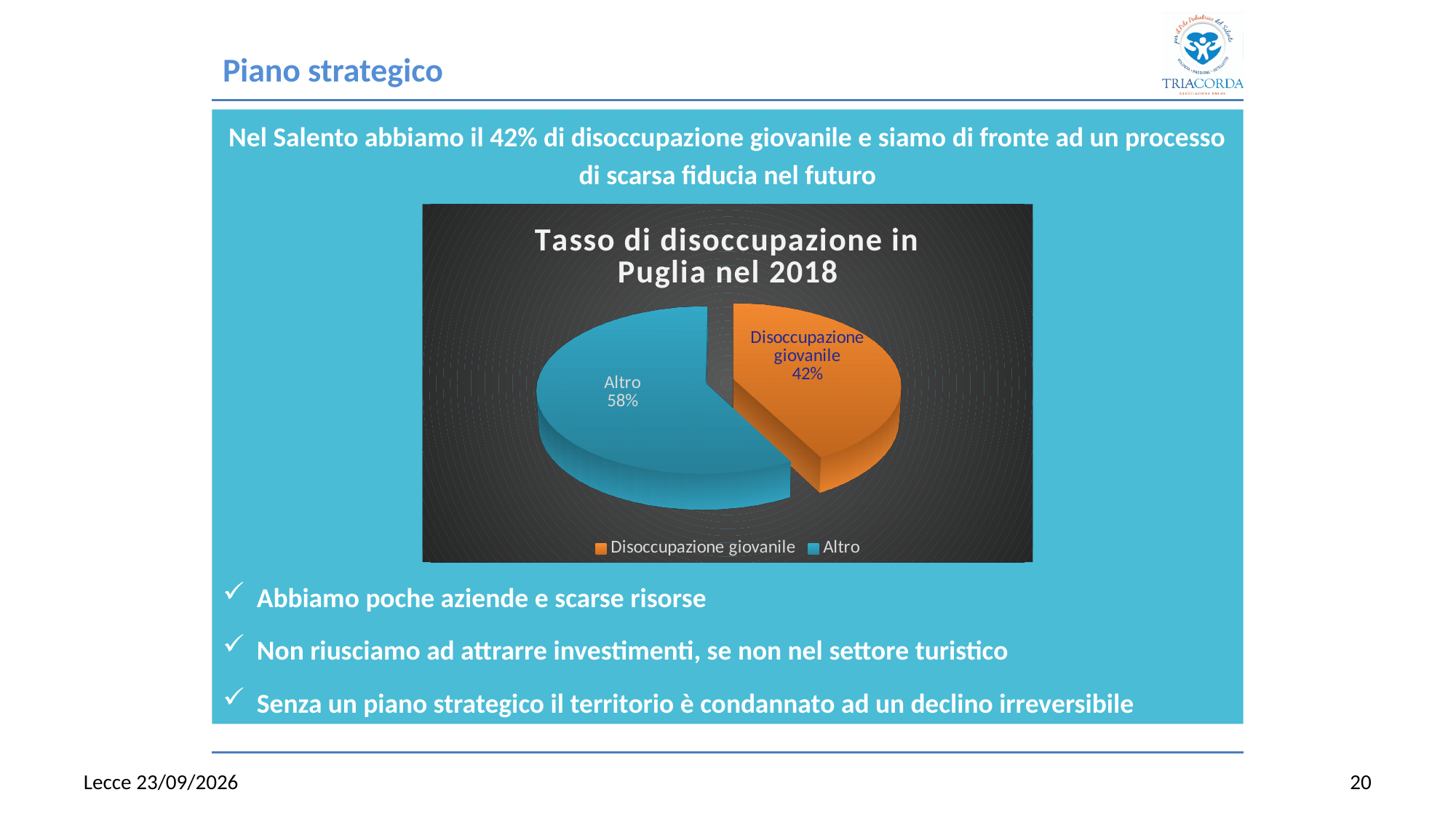
What share of the pie does "Altro" represent? 58% What is the title of the chart? Tasso di disoccupazione in Puglia nel 2018 How many slices does the pie chart have? 2 Which slice is the largest in the pie chart? Altro What is the difference in percentage points between the "Altro" slice and the "Disoccupazione giovanile" slice? 16 percentage points Which is larger, the "Altro" slice or the "Disoccupazione giovanile" slice? Altro How many entries does the legend list? 2 What kind of chart is shown on the slide? Pie chart Is the share for "Disoccupazione giovanile" greater or less than 50%? less What colour is the "Disoccupazione giovanile" slice? Orange Which slice is the smallest in the pie chart? Disoccupazione giovanile What share of the pie does "Disoccupazione giovanile" represent? 42%